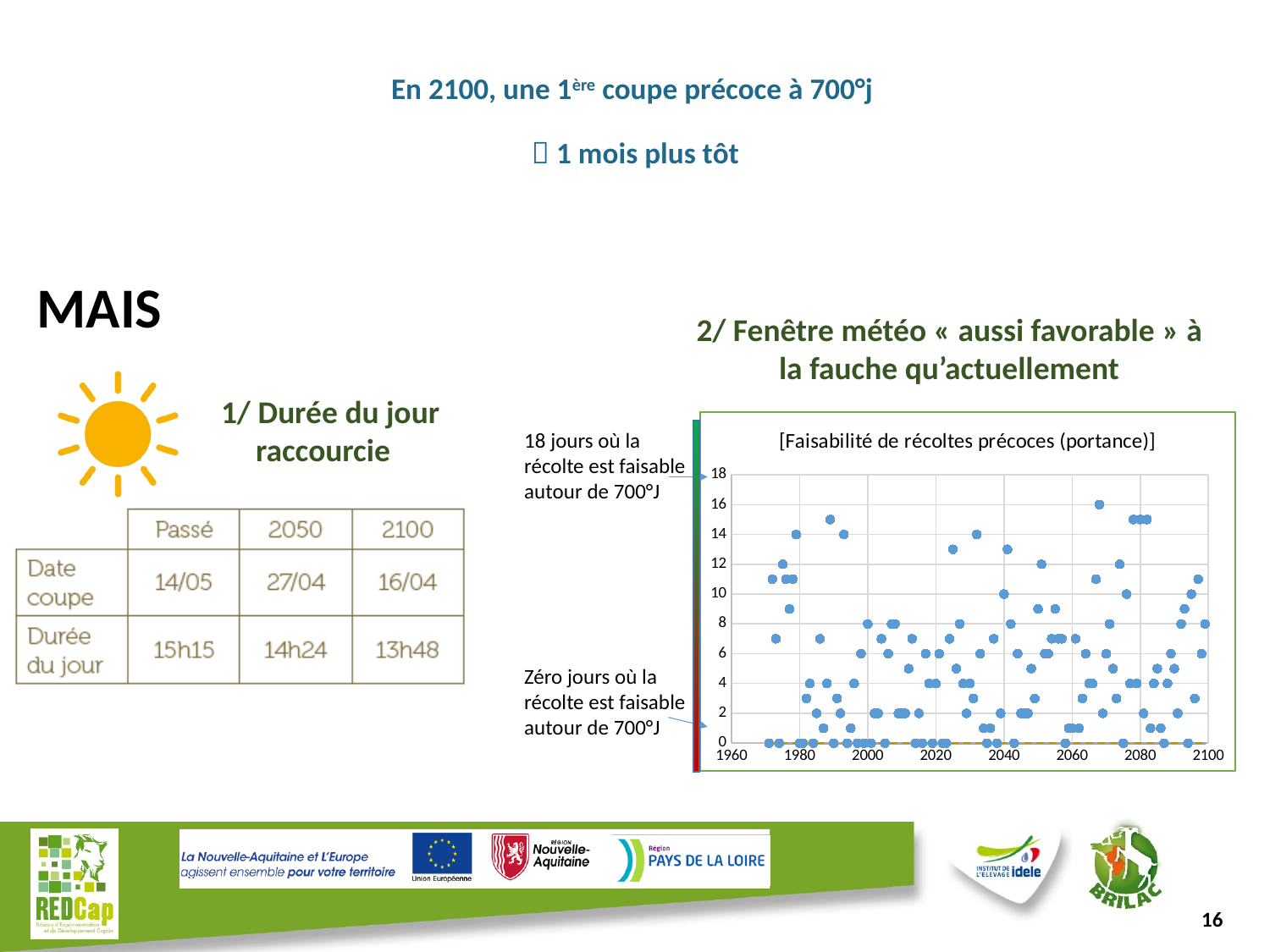
What is the title of the chart on the slide? [Faisabilité de récoltes précoces (portance)] Is the highest plotted point on the chart greater or less than 18? less Is the highest plotted point on the chart greater or less than 14? greater What is the highest value shown on the chart's vertical axis? 18 How many year tick labels are shown on the chart's horizontal axis? 8 What is the first year shown on the chart's horizontal axis? 1960 According to the annotation next to the top of the chart's vertical axis, how many days is the harvest feasible around 700°J at the maximum? 18 jours What is the lowest value plotted on the chart? 0 What is the last year shown on the chart's horizontal axis? 2100 What kind of chart is shown on the slide? scatter chart